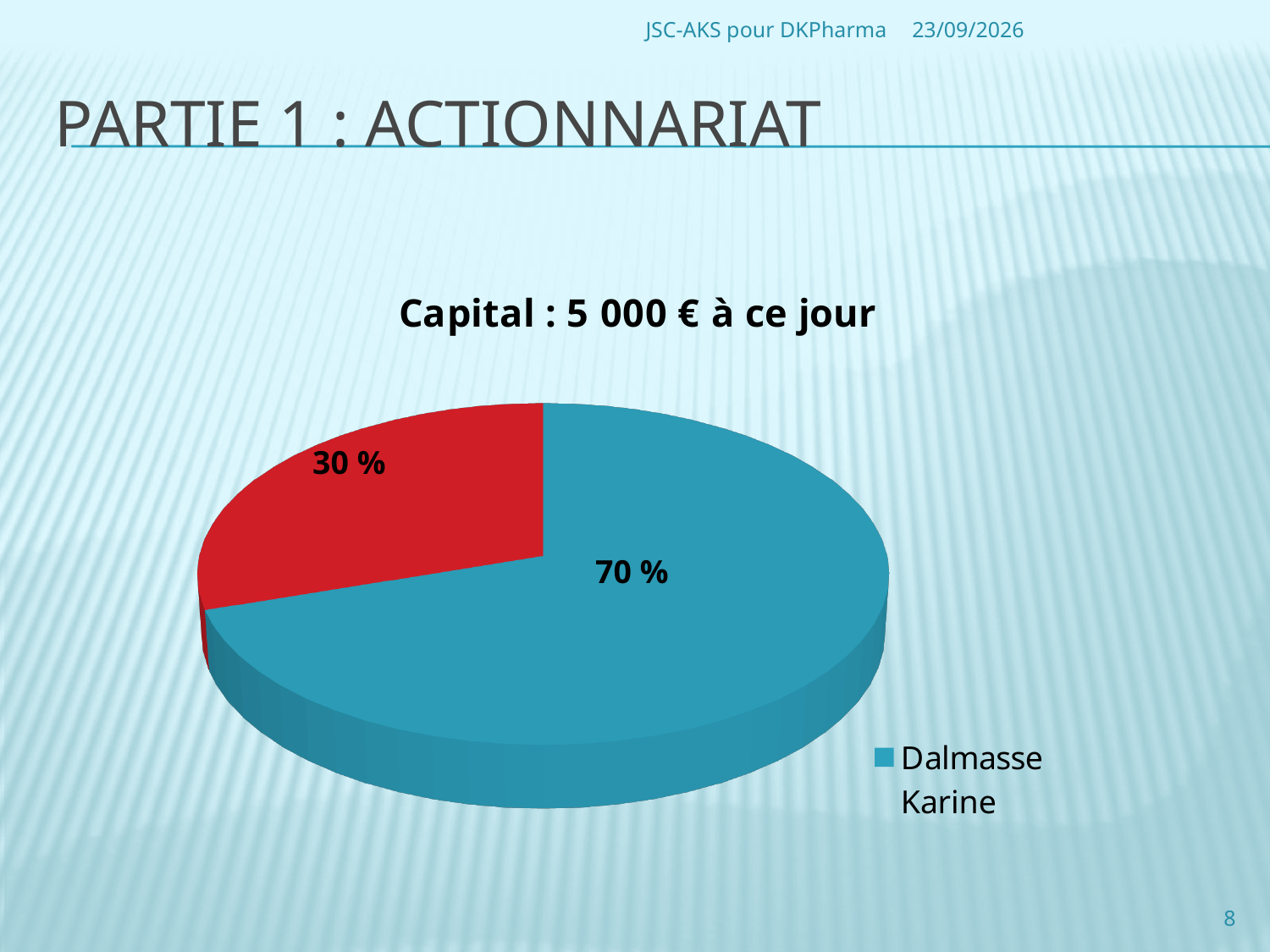
How many slices does the pie chart have? 2 What kind of chart is shown on the slide? Pie chart What is the value shown on the red slice of the pie? 30 % What is the value shown on the blue slice of the pie? 70 % Which shareholder name appears in the chart legend? Dalmasse Karine What is the difference in percentage points between the blue slice and the red slice? 40 percentage points What is the title of the chart? Capital : 5 000 € à ce jour Which is larger, the blue slice or the red slice? The blue slice Which slice is the largest in the pie chart? Dalmasse Karine (70 %) What is the value of the smallest slice in the pie chart? 30 % What share of the pie does Dalmasse Karine hold? 70 % Is the share held by Dalmasse Karine greater or less than 50 %? greater